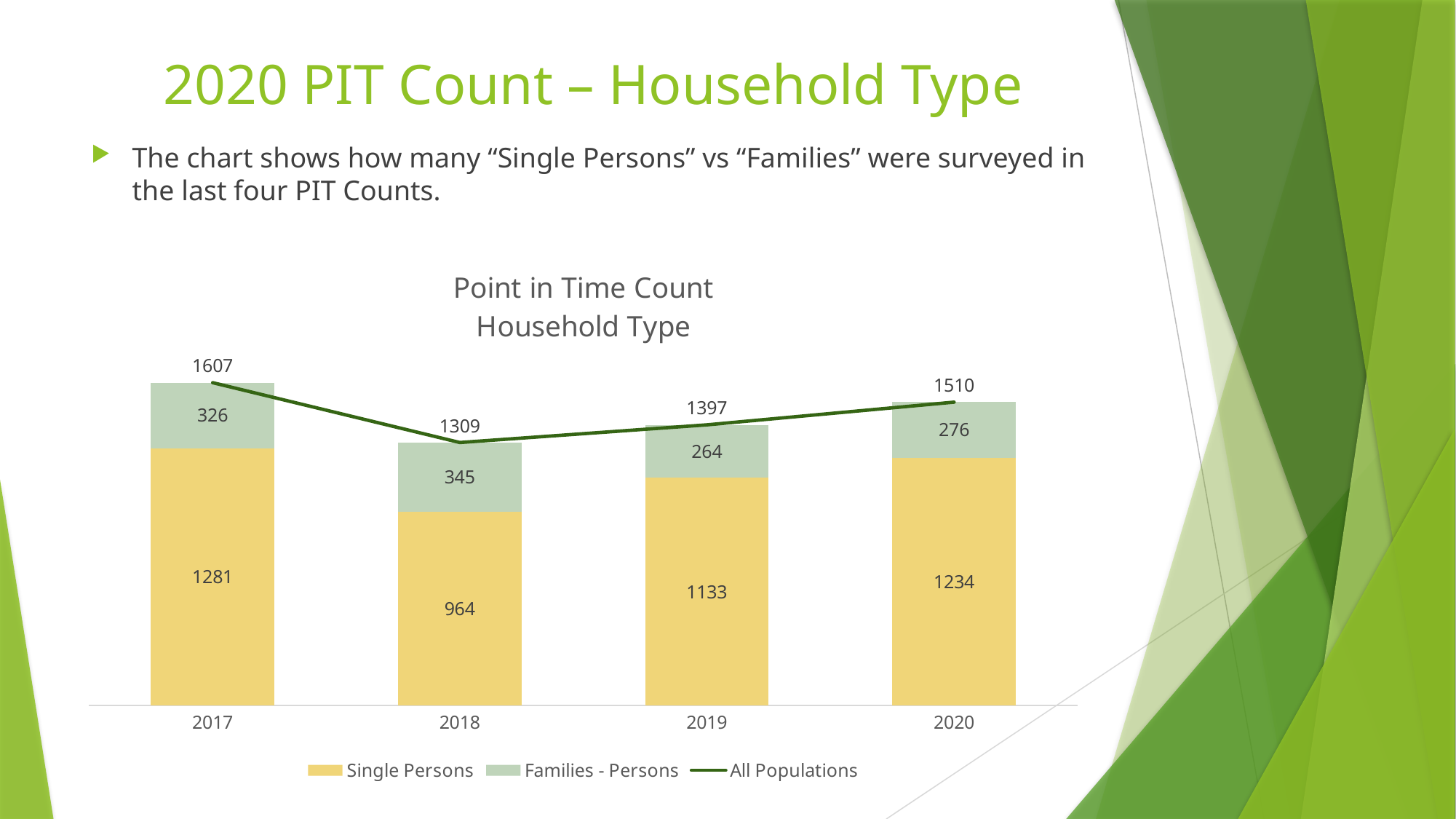
How many years are shown on the x axis? 4 What is the title of the chart? Point in Time Count Household Type What is the value for Single Persons in 2017? 1281 Which year has the highest All Populations value? 2017 What is the difference between the Single Persons values for 2017 and 2018? 317 What is the value for Families - Persons in 2018? 345 Which year has the lowest Single Persons value? 2018 What kind of chart is this? Stacked bar chart with a line Which is larger, the Families - Persons value for 2017 or for 2020? 2017 What is the All Populations value for 2019? 1397 How many series does the legend list? 3 Does the All Populations line rise or fall from 2018 to 2020? Rise